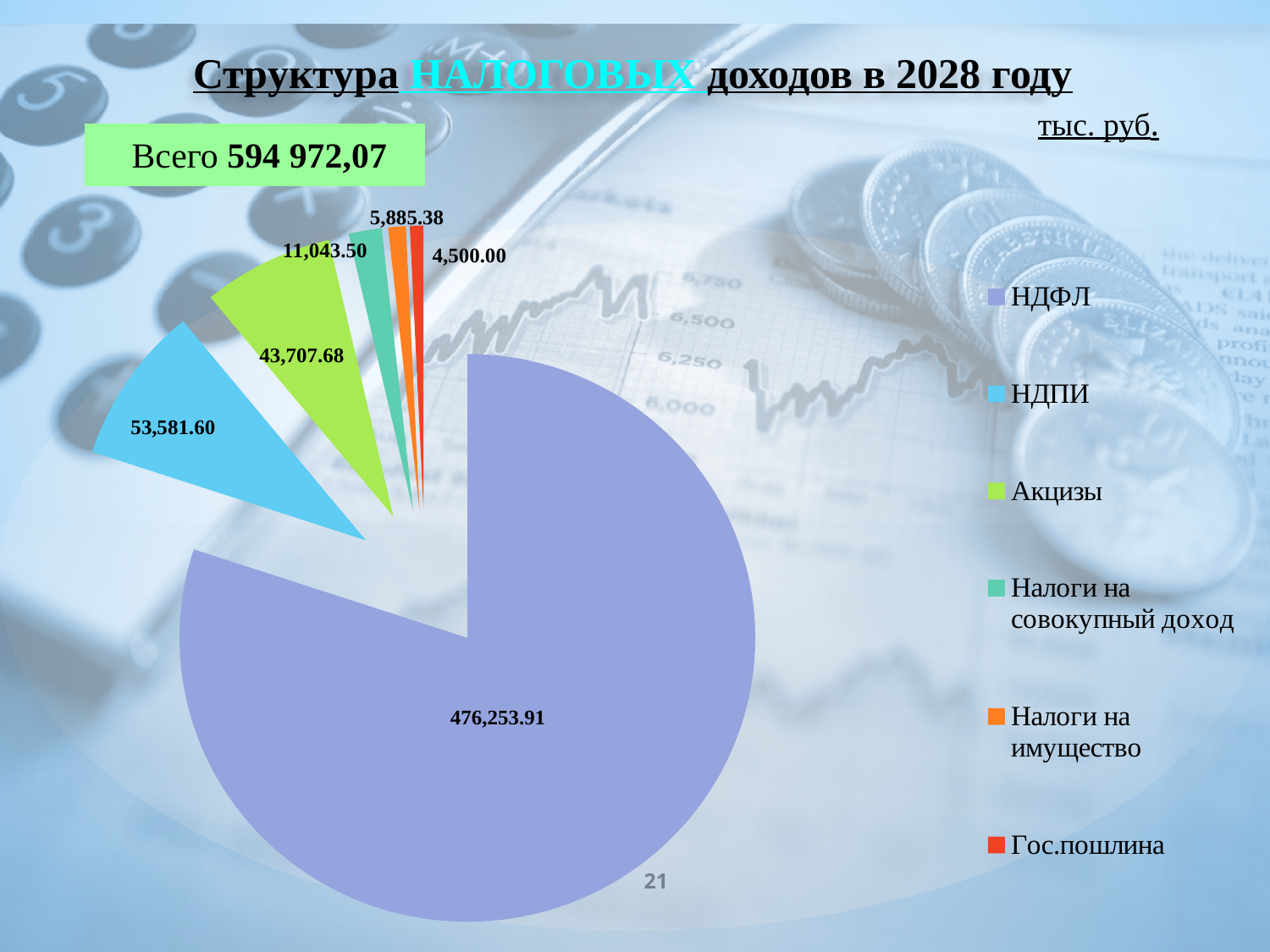
What total value is shown in the green box on the slide? 594 972,07 What kind of chart is shown on the slide? pie chart What is the value for Налоги на совокупный доход? 11,043.50 What is the value for НДПИ? 53,581.60 What is the value for Акцизы? 43,707.68 How many categories does the legend list? 6 Which is larger, Налоги на имущество or Гос.пошлина? Налоги на имущество What is the value for НДФЛ? 476,253.91 Which category has the largest slice of the pie? НДФЛ What is the difference between the values for НДПИ and Акцизы? 9,873.92 What is the value for Гос.пошлина? 4,500.00 Which category has the smallest slice of the pie? Гос.пошлина